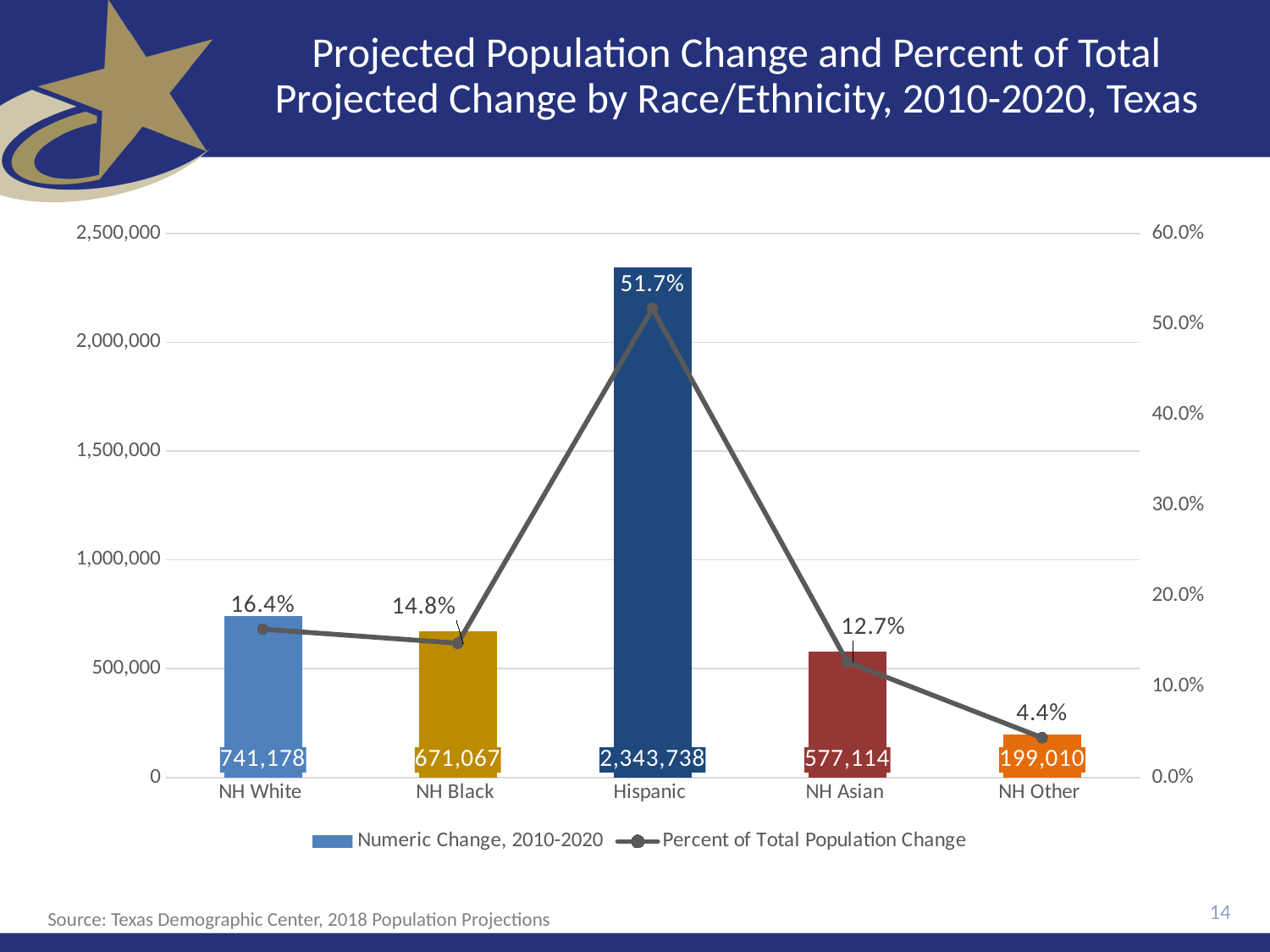
What is the Percent of Total Population Change for NH Asian? 12.7% Which race/ethnicity category has the lowest Percent of Total Population Change? NH Other What is the source cited at the bottom of the slide? Texas Demographic Center, 2018 Population Projections How many series does the legend list? 2 Which race/ethnicity category has the highest Numeric Change, 2010-2020? Hispanic What is the Numeric Change, 2010-2020 for NH Other? 199,010 How many race/ethnicity categories are shown on the x axis? 5 What is the difference in Numeric Change, 2010-2020 between NH White and NH Black? 70,111 What kind of chart is used to show the Numeric Change, 2010-2020 series? Bar chart What is the Numeric Change, 2010-2020 for Hispanic? 2,343,738 Is the Numeric Change, 2010-2020 for NH White greater or less than 500,000? greater Which has a larger Numeric Change, 2010-2020: NH Black or NH Asian? NH Black